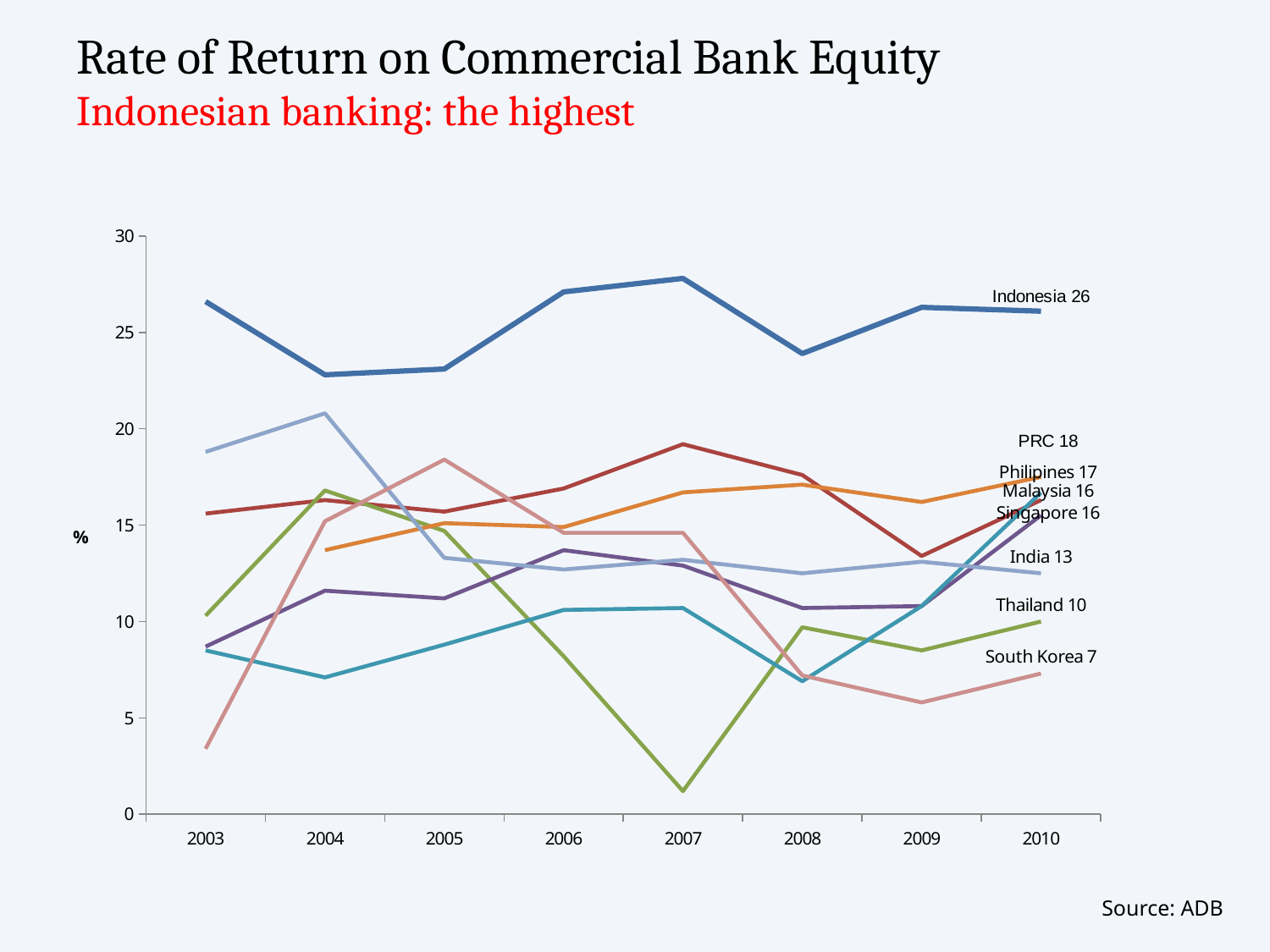
What is the rate of return on commercial bank equity for Indonesia in 2010? 26 What type of chart is shown on the slide? line chart Which country has the highest rate of return in 2010? Indonesia How many years are shown on the x axis? 8 What is the difference between the 2010 values for Indonesia and South Korea? 19 What is the value labelled for PRC at the end of the series? 18 Is the value for Thailand in 2007 greater or less than 5? less Which has a higher 2010 value, PRC or India? PRC Is the value for Indonesia in 2003 greater or less than 25? greater Which country has the lowest rate of return in 2010? South Korea What is the source cited for the chart? ADB What is the value labelled for South Korea at the end of the series? 7